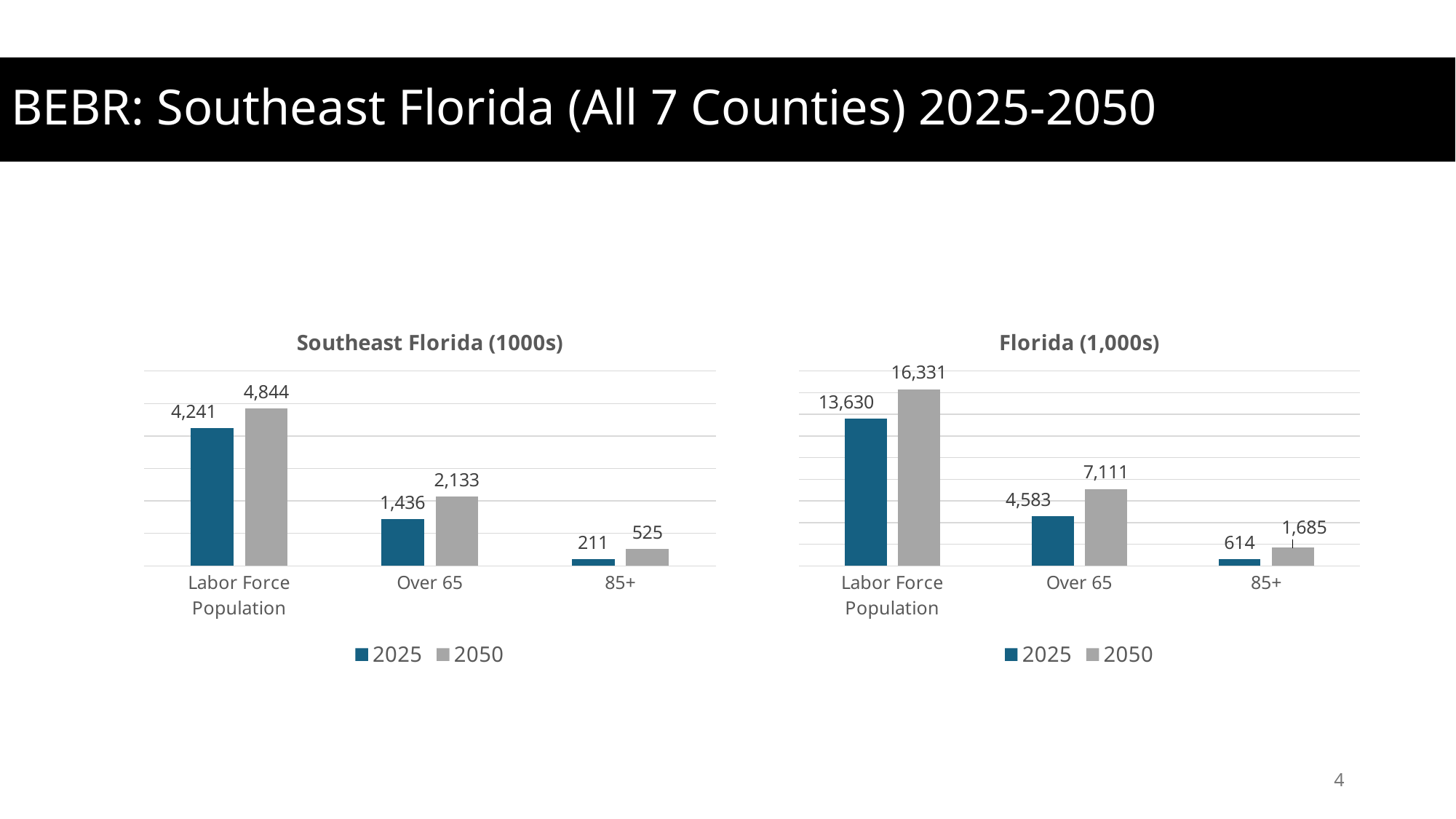
How many series does the legend of the Florida (1,000s) chart list? 2 In the Florida (1,000s) chart, which category has the highest 2050 value? Labor Force Population How many categories are shown on the x axis of the Southeast Florida (1000s) chart? 3 In the Southeast Florida (1000s) chart, which category has the lowest 2025 value? 85+ In the Southeast Florida (1000s) chart, what is the 2025 value for Labor Force Population? 4,241 In the Southeast Florida (1000s) chart, what is the 2050 value for Over 65? 2,133 In the Florida (1,000s) chart, what is the 2025 value for 85+? 614 In the Southeast Florida (1000s) chart, what is the difference between the 2050 and 2025 values for Labor Force Population? 603 In the Florida (1,000s) chart, which is larger for 85+: the 2025 value or the 2050 value? 2050 In the Florida (1,000s) chart, what is the difference between the 2050 and 2025 values for Over 65? 2,528 In the Florida (1,000s) chart, what is the 2050 value for Labor Force Population? 16,331 What kind of chart is the Southeast Florida (1000s) chart? Bar chart